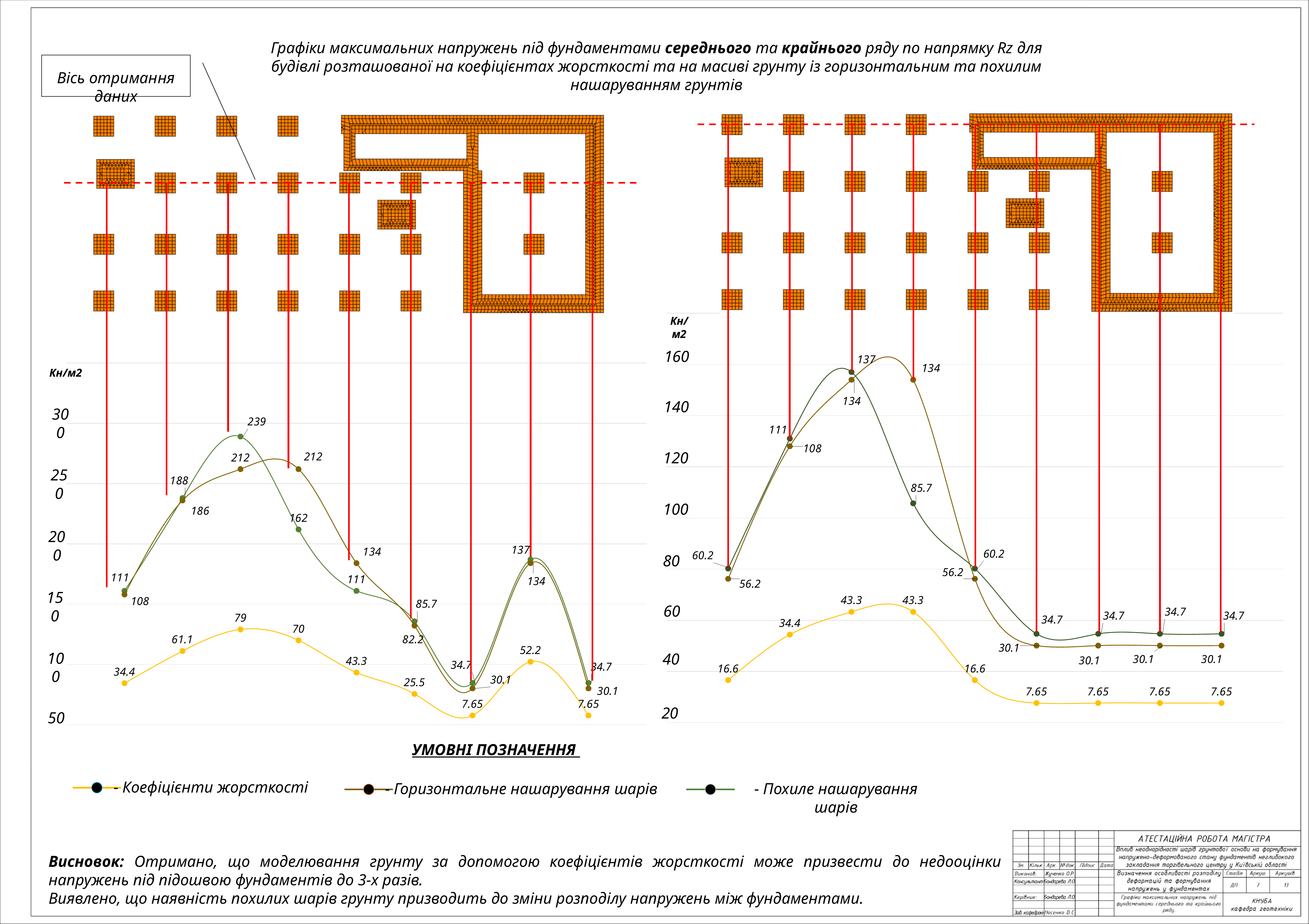
On the right chart (крайнього ряду), what is the value of the first point of the Горизонтальне нашарування шарів (brown) series? 56.2 On the left chart (середнього ряду), which is larger: the first point of the green series (111) or the first point of the brown series (108)? 111 (green series) Which colour is used for the Коефіцієнти жорсткості series in the legend? yellow On the left chart (середнього ряду), what is the difference between the peak of the green series (239) and the peak of the brown series (212)? 27 On the right chart (крайнього ряду), what is the highest value labelled on the Коефіцієнти жорсткості (yellow) series? 43.3 On the left chart (середнього ряду), what is the highest value labelled on the Коефіцієнти жорсткості (yellow) series? 79 On the left chart (середнього ряду), is the peak value of the Коефіцієнти жорсткості (yellow) series greater or less than 100? less On the left chart (середнього ряду), what is the lowest value labelled on the Коефіцієнти жорсткості (yellow) series? 7.65 What kind of chart is shown on the left (середнього ряду)? line chart How many series does the legend list? 3 On the right chart (крайнього ряду), what is the value of the first point of the Похиле нашарування шарів (green) series? 60.2 On the left chart (середнього ряду), what is the highest value labelled on the Похиле нашарування шарів (green) series? 239